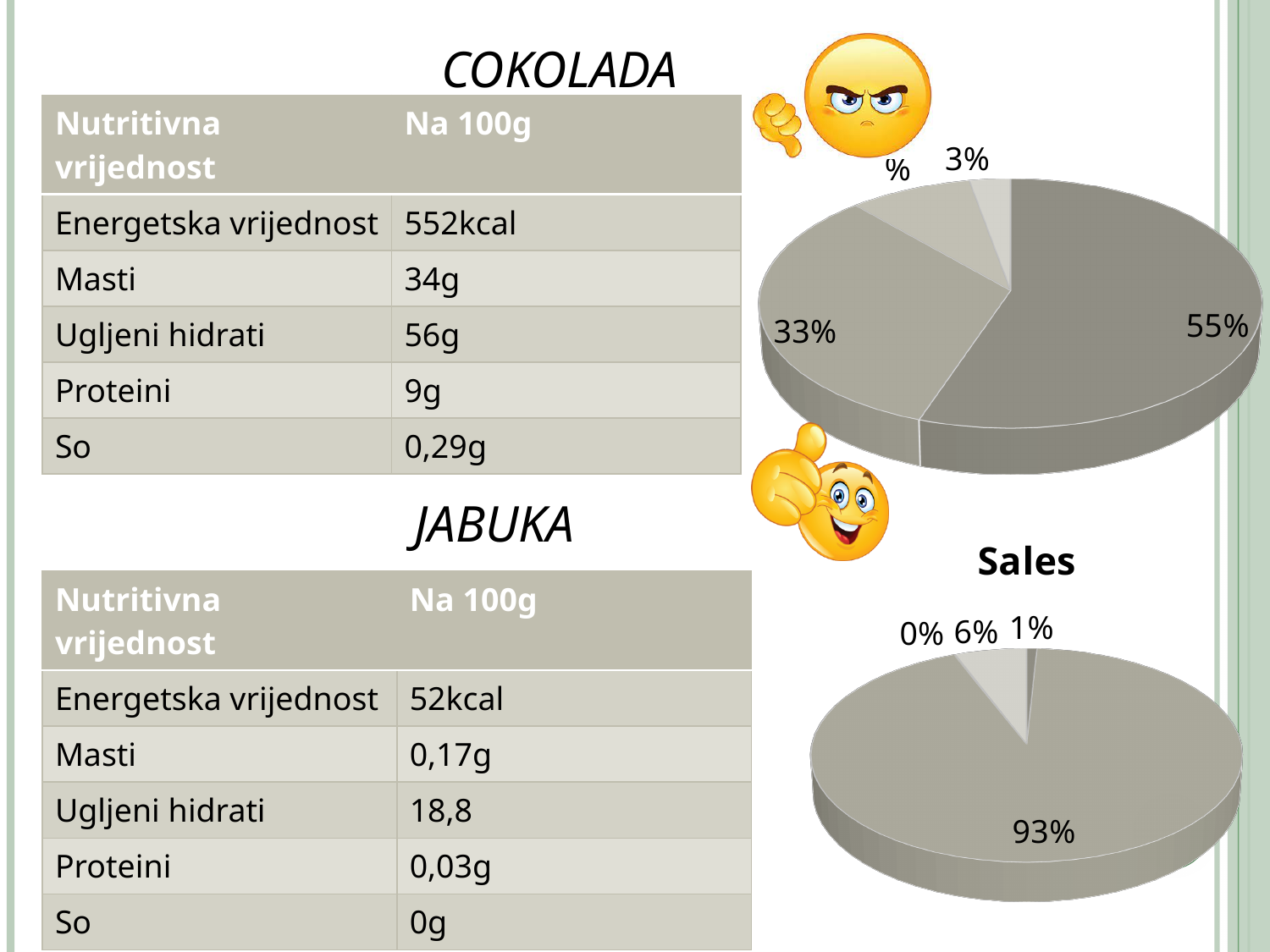
In the pie chart at the top right of the slide, what is the difference in percentage points between the 55% slice and the 33% slice? 22 percentage points In the "Sales" pie chart, what share does the largest slice have? 93% In the pie chart at the top right of the slide, what share does the largest slice have? 55% Is the largest slice of the "Sales" pie chart greater or less than 50%? greater Which is larger: the largest slice of the "Sales" pie chart or the largest slice of the pie chart at the top right of the slide? The largest slice of the "Sales" pie chart (93%) How many percentage data labels are shown on the "Sales" pie chart? 4 What kind of chart is the chart titled "Sales" at the bottom right of the slide? Pie chart What kind of chart is the chart at the top right of the slide? Pie chart What is the title of the pie chart at the bottom right of the slide? Sales In the "Sales" pie chart, what is the smallest share shown as a data label? 0% In the "Sales" pie chart, what is the difference in percentage points between the 93% slice and the 6% slice? 87 percentage points In the pie chart at the top right of the slide, what share does the second-largest slice have? 33%